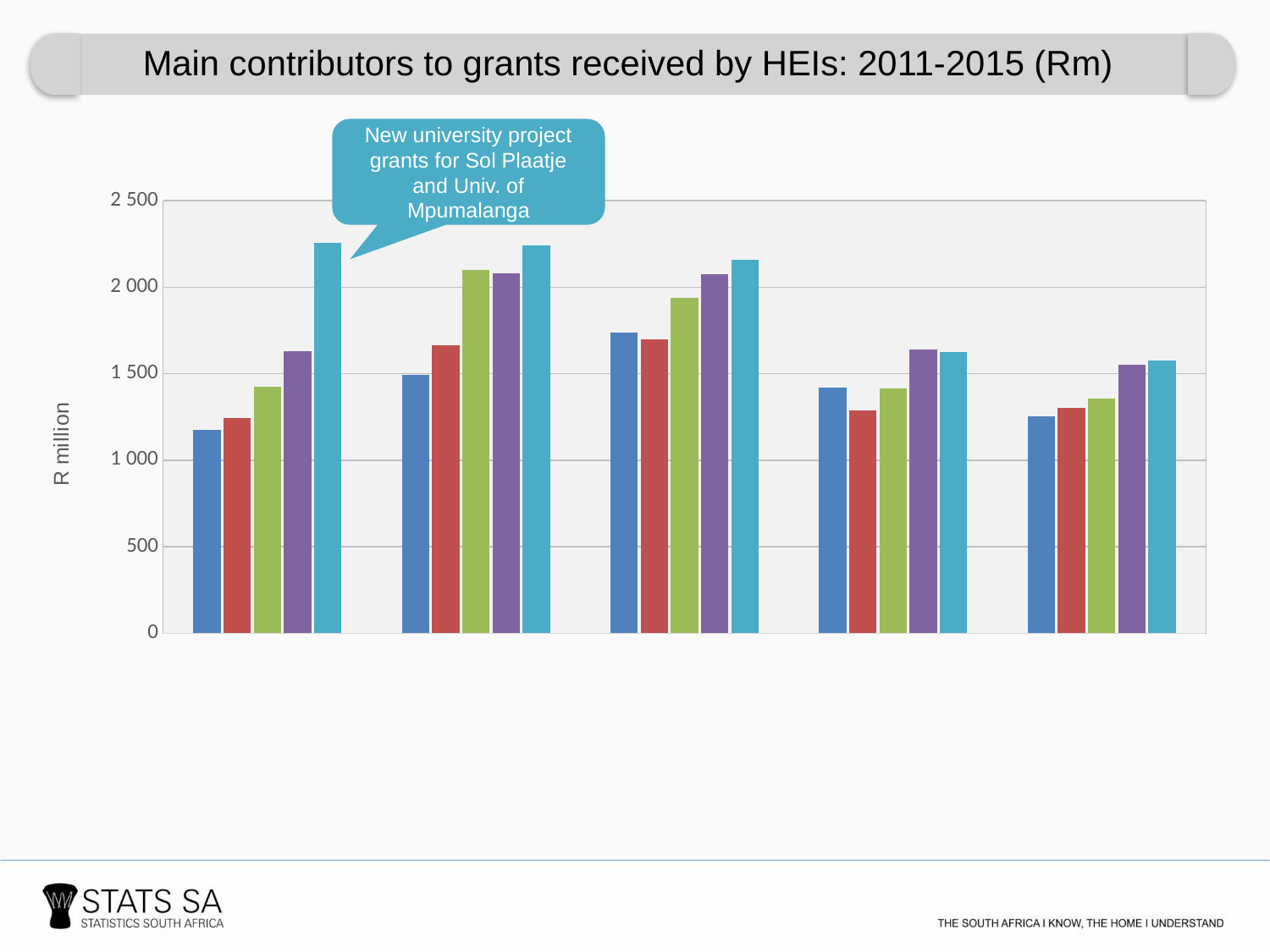
Is the value of the blue bar in the first (leftmost) group greater or less than 1 500? less In the third group from the left, is the purple bar taller or shorter than the blue bar? Taller What is the highest tick value shown on the vertical axis? 2 500 What is the label on the vertical axis of the chart? R million Do the teal bars rise or fall from the first group to the last group along the x axis? Fall How many groups of bars are plotted along the x axis? 5 In the first (leftmost) group of bars, which coloured bar is the tallest? The teal (light blue) bar Is the value of the teal bar in the first (leftmost) group greater or less than 2 000? greater What kind of chart is shown on the slide? Bar chart In the fourth group from the left, which coloured bar is the shortest? The red bar What is the title of the chart? Main contributors to grants received by HEIs: 2011-2015 (Rm) How many bars are there in each group? 5